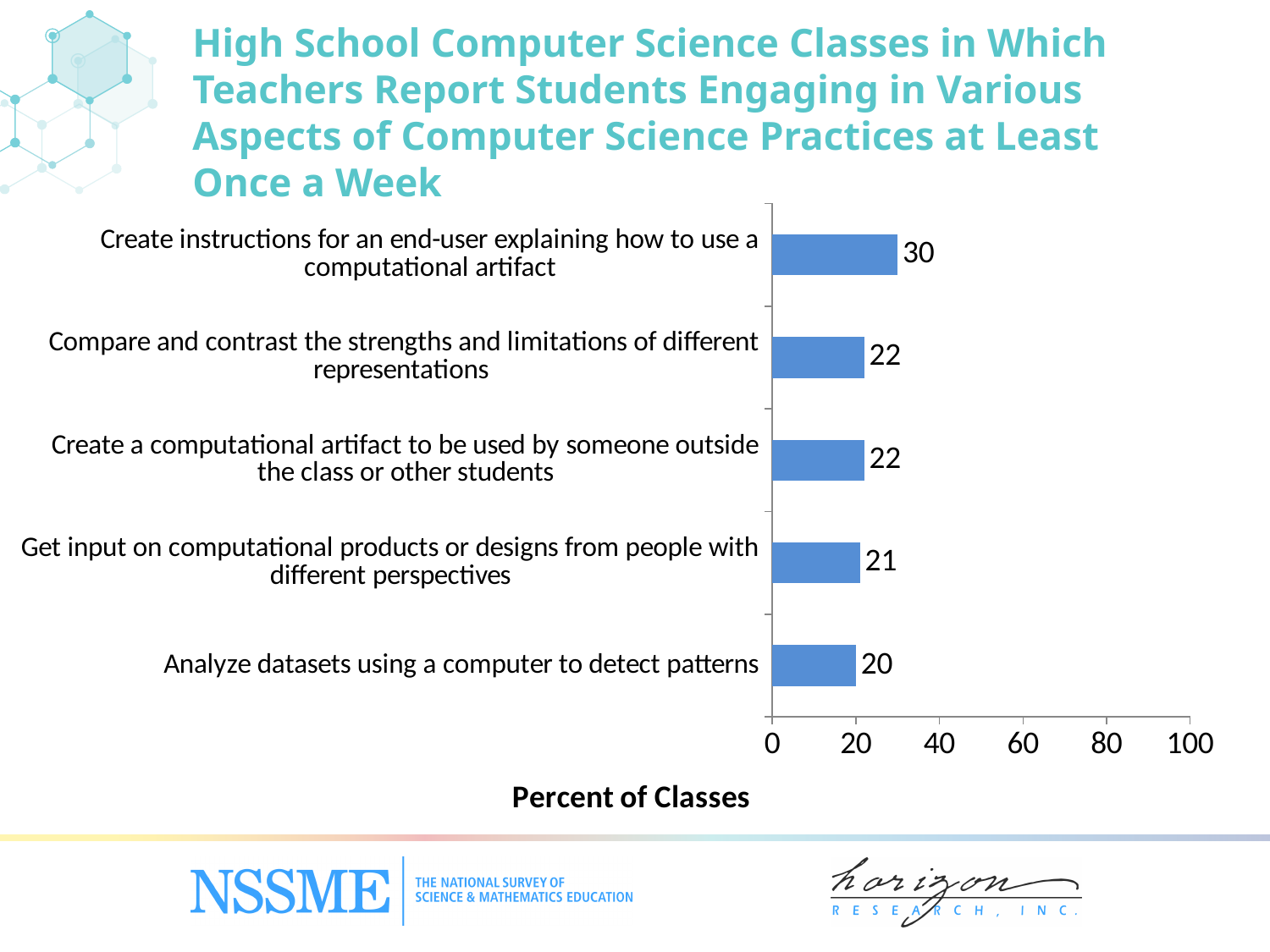
How many categories are shown in the chart? 5 Is the value for "Create instructions for an end-user explaining how to use a computational artifact" greater or less than 40? less What is the label of the horizontal axis? Percent of Classes What is the difference between the value for creating instructions for an end-user and the value for analyzing datasets to detect patterns? 10 Which category has the lowest percent of classes? Analyze datasets using a computer to detect patterns What is the value for "Compare and contrast the strengths and limitations of different representations"? 22 What percent of classes report students creating instructions for an end-user explaining how to use a computational artifact at least once a week? 30 Which is larger: the value for "Get input on computational products or designs from people with different perspectives" or the value for "Create instructions for an end-user explaining how to use a computational artifact"? Create instructions for an end-user explaining how to use a computational artifact Which category has the highest percent of classes? Create instructions for an end-user explaining how to use a computational artifact What is the value for "Get input on computational products or designs from people with different perspectives"? 21 What is the value for "Analyze datasets using a computer to detect patterns"? 20 What kind of chart is shown on the slide? Bar chart